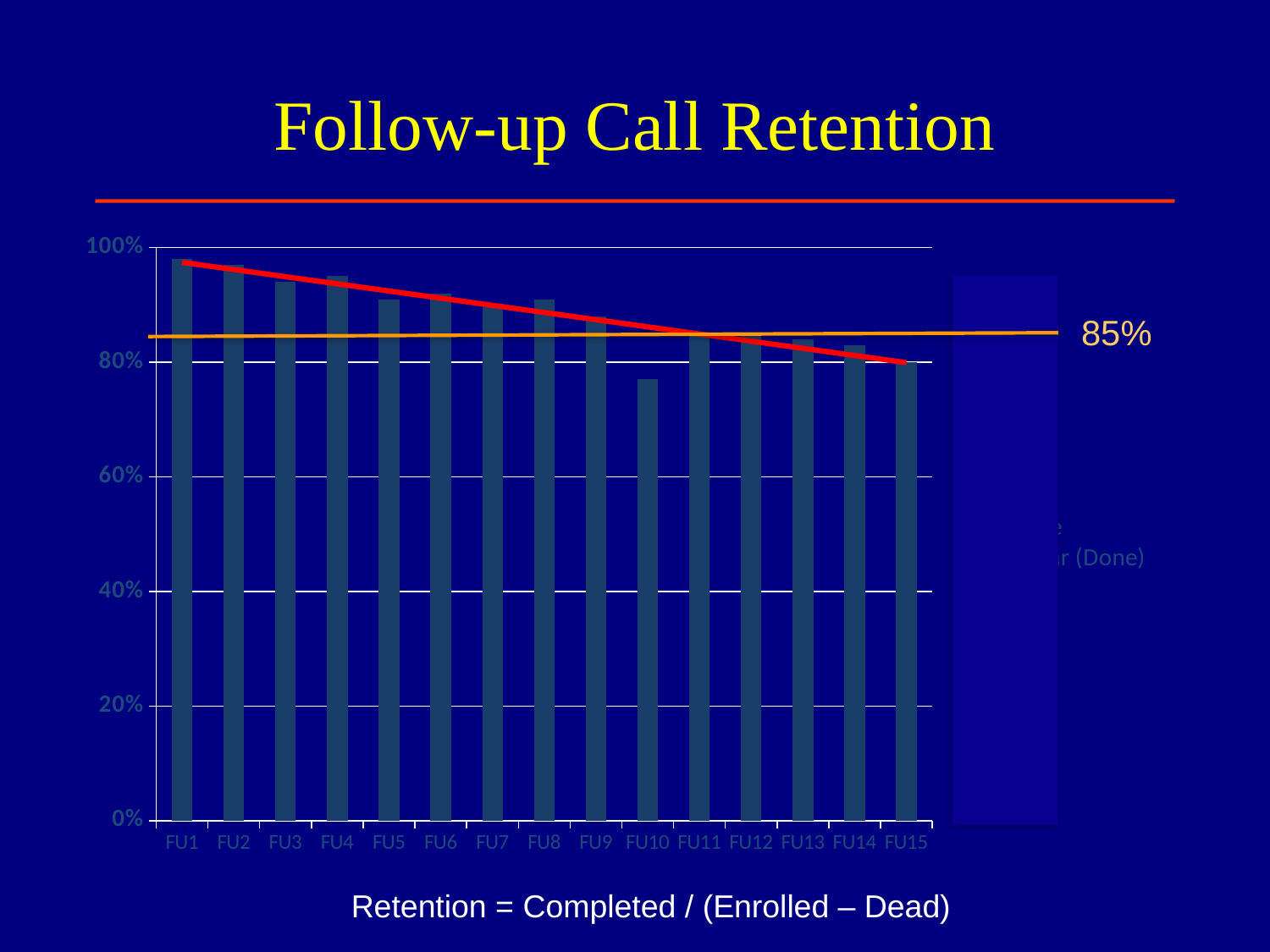
What is the title of the chart? Follow-up Call Retention What kind of chart is shown on the slide? bar chart What value is labelled on the orange horizontal reference line? 85% Which follow-up call has the lowest retention? FU10 Which has the higher retention, FU1 or FU15? FU1 Is the value for FU1 greater or less than 80%? greater Which has the higher retention, FU10 or FU11? FU11 Is the value for FU10 greater or less than 80%? less How many follow-up call categories are shown on the x axis? 15 Is the value for FU13 greater or less than 60%? greater Do the retention values generally rise or fall from FU1 to FU15? fall